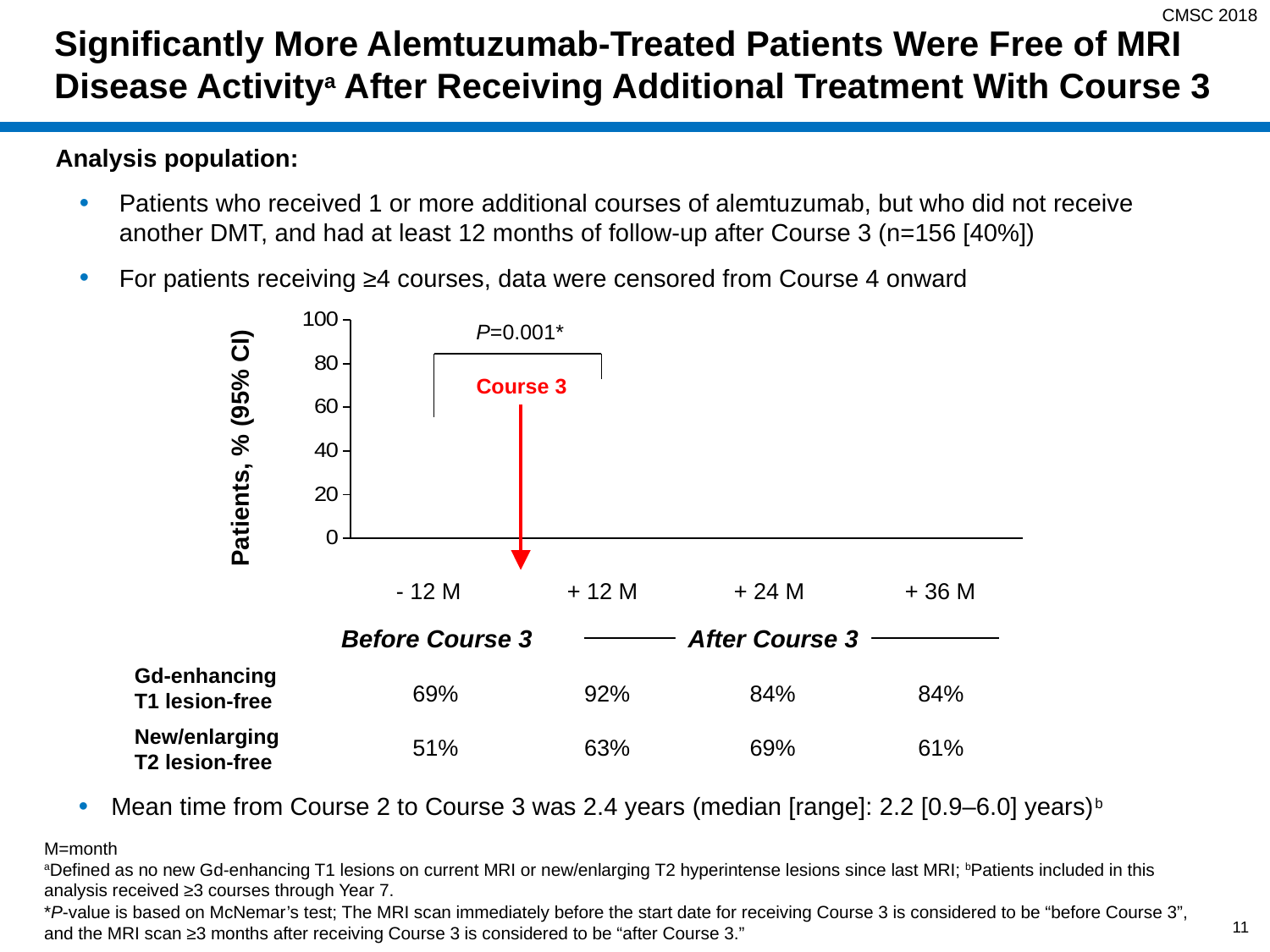
At which time point was the Gd-enhancing T1 lesion-free percentage highest? + 12 M What percentage of patients were New/enlarging T2 lesion-free at +24 M after Course 3? 69% What percentage of patients were Gd-enhancing T1 lesion-free at +12 M after Course 3? 92% What is the label of the y axis of the chart? Patients, % (95% CI) What percentage of patients were New/enlarging T2 lesion-free at -12 M before Course 3? 51% Which is larger: the Gd-enhancing T1 lesion-free percentage at +36 M or the New/enlarging T2 lesion-free percentage at +36 M? Gd-enhancing T1 lesion-free How many time points are shown on the x axis of the chart? 4 What is the difference in the New/enlarging T2 lesion-free percentage between +24 M and +36 M? 8% What percentage of patients were Gd-enhancing T1 lesion-free at -12 M (before Course 3)? 69% What P-value is shown on the chart? P=0.001* At which time point was the New/enlarging T2 lesion-free percentage lowest? - 12 M What is the difference in the Gd-enhancing T1 lesion-free percentage between +12 M and -12 M? 23%